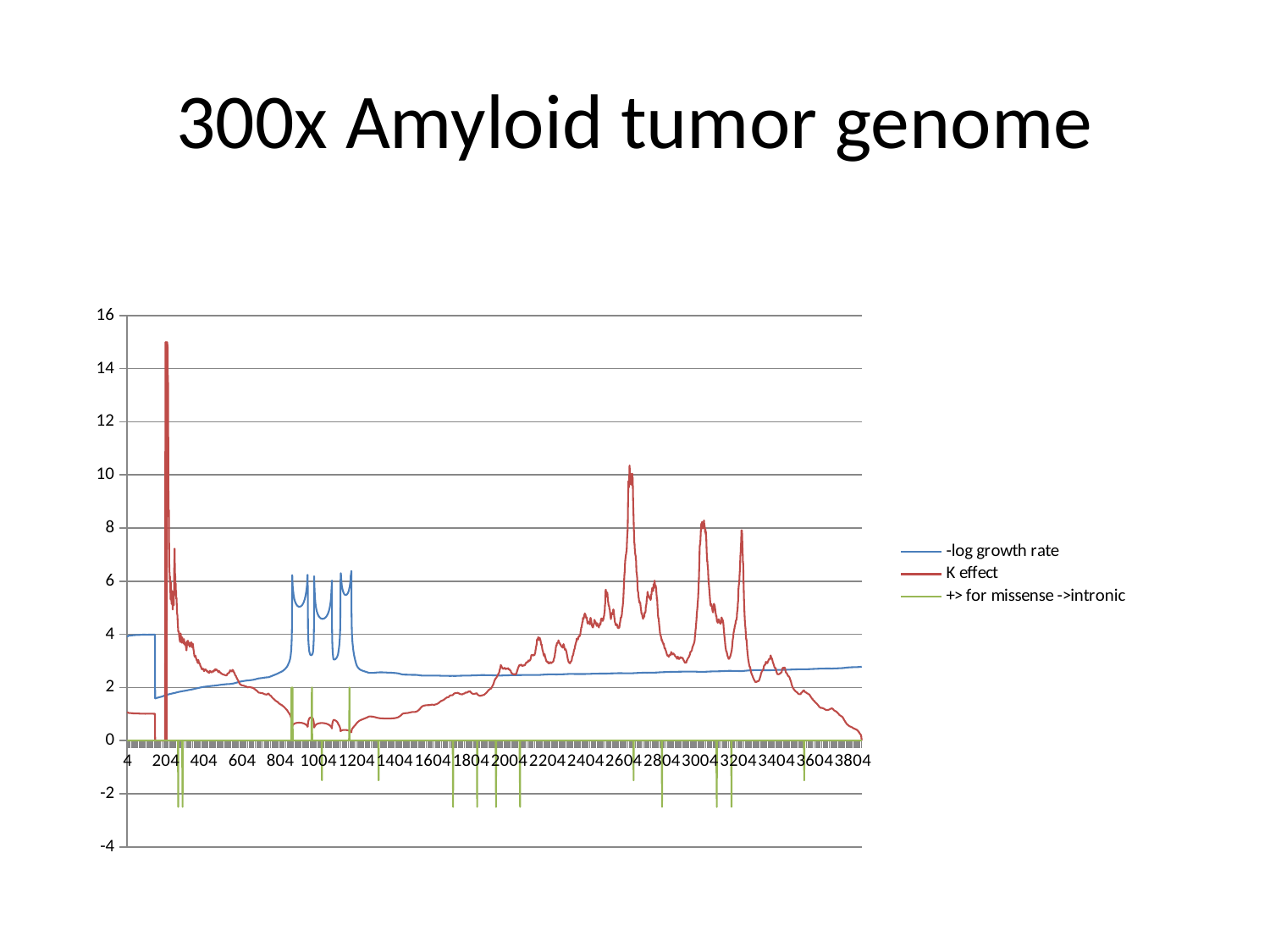
What is the highest value shown on the y axis? 16 Is the highest peak of the K effect series (near x = 204) greater or less than 14? greater What is the title of the slide? 300x Amyloid tumor genome How many series does the legend list? 3 Which series reaches the highest value on the chart? K effect Is the value of -log growth rate at x = 2004 greater or less than 4? less Which series is drawn in red? K effect Is the value of K effect at x = 3804 greater or less than 2? less Near x = 2604, which series is higher: K effect or -log growth rate? K effect Near x = 1004, which series is higher: -log growth rate or K effect? -log growth rate What kind of chart is shown on the slide? line chart